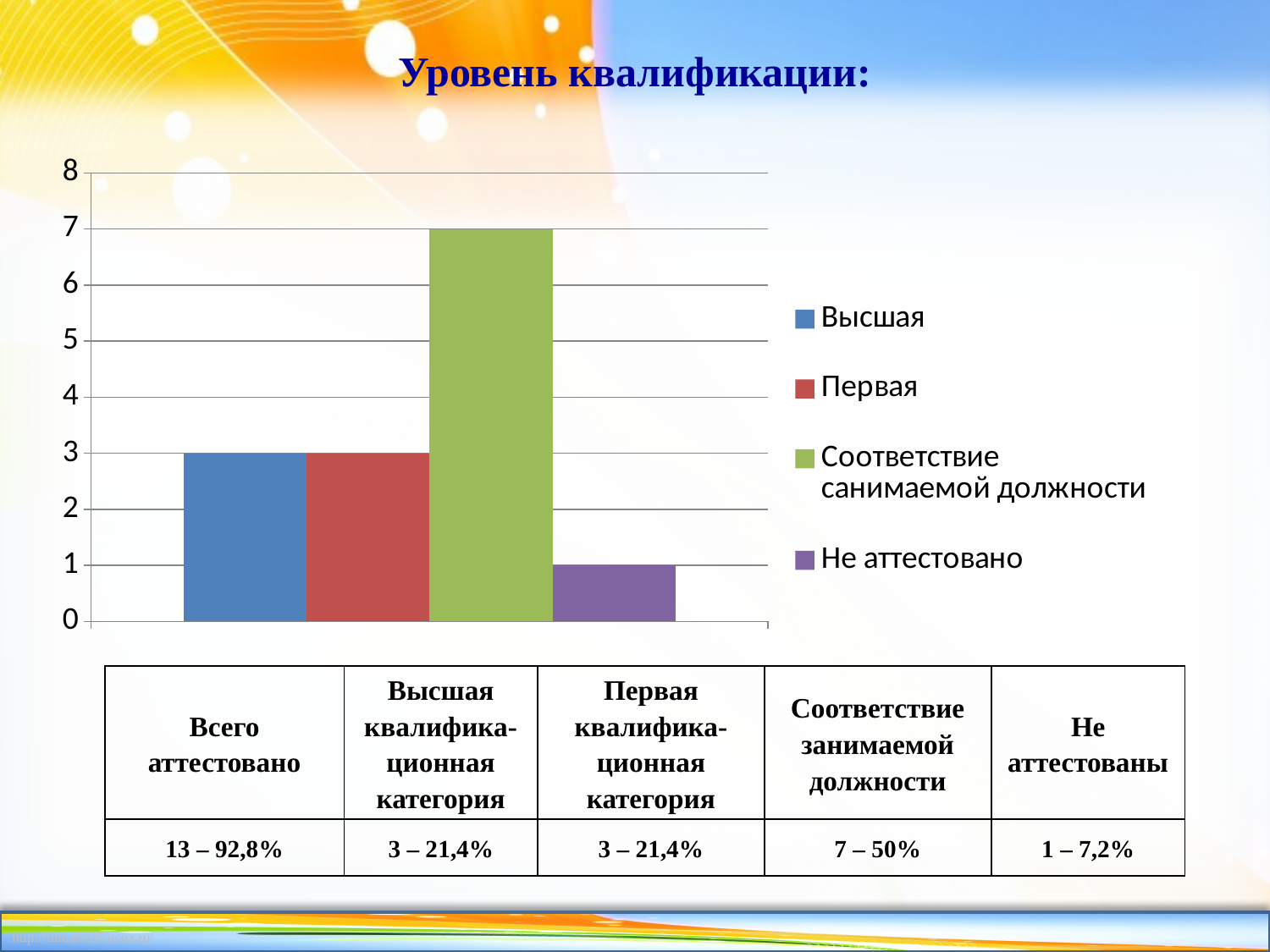
What is the difference between the bar for Соответствие санимаемой должности and the bar for Высшая? 4 Which is larger, the bar for Первая or the bar for Не аттестовано? Первая What is the value of the bar for Первая? 3 What is the value of the bar for Соответствие санимаемой должности? 7 Is the value for Соответствие санимаемой должности greater or less than 5? greater What is the title of the slide above the chart? Уровень квалификации: What type of chart is shown on the slide? bar chart What is the value of the bar for Не аттестовано? 1 What is the value of the bar for Высшая? 3 How many series does the legend list? 4 Which series has the lowest bar? Не аттестовано Which series has the highest bar? Соответствие санимаемой должности